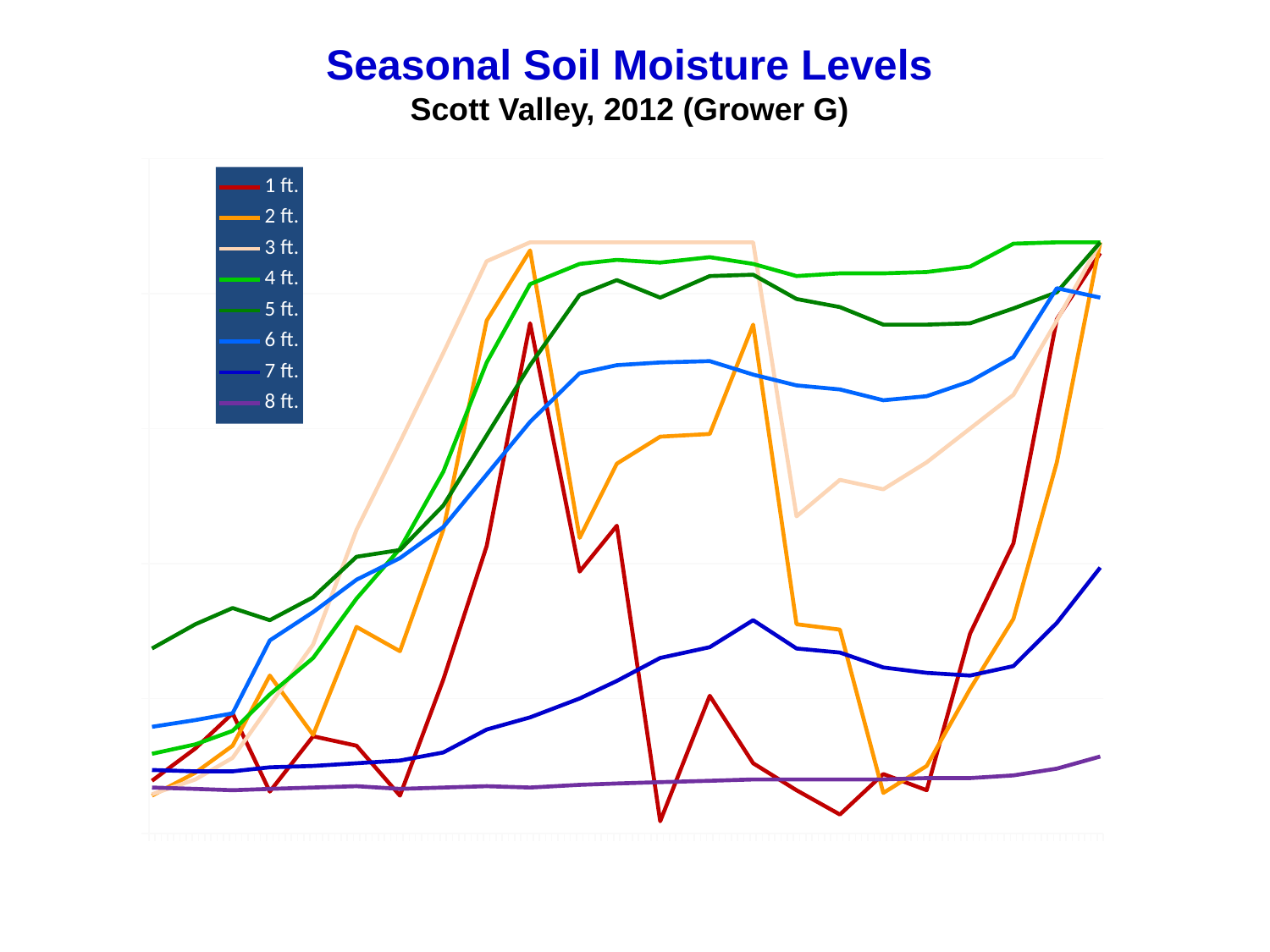
At the right end of the chart, which line is higher, 6 ft. or 8 ft.? 6 ft. At the right end of the chart, which line is higher, 7 ft. or 8 ft.? 7 ft. Does the 8 ft. line rise or fall from left to right across the chart? rises What is the title of the chart? Seasonal Soil Moisture Levels What kind of chart is shown on the slide? line chart How many series does the legend list? 8 Which series is the highest at the left end of the chart? 5 ft. At the left end of the chart, which line is higher, 5 ft. or 1 ft.? 5 ft. Which series is the lowest at the right end of the chart? 8 ft. Does the 7 ft. line rise or fall overall from left to right across the chart? rises What colour is the 8 ft. line in the chart? purple